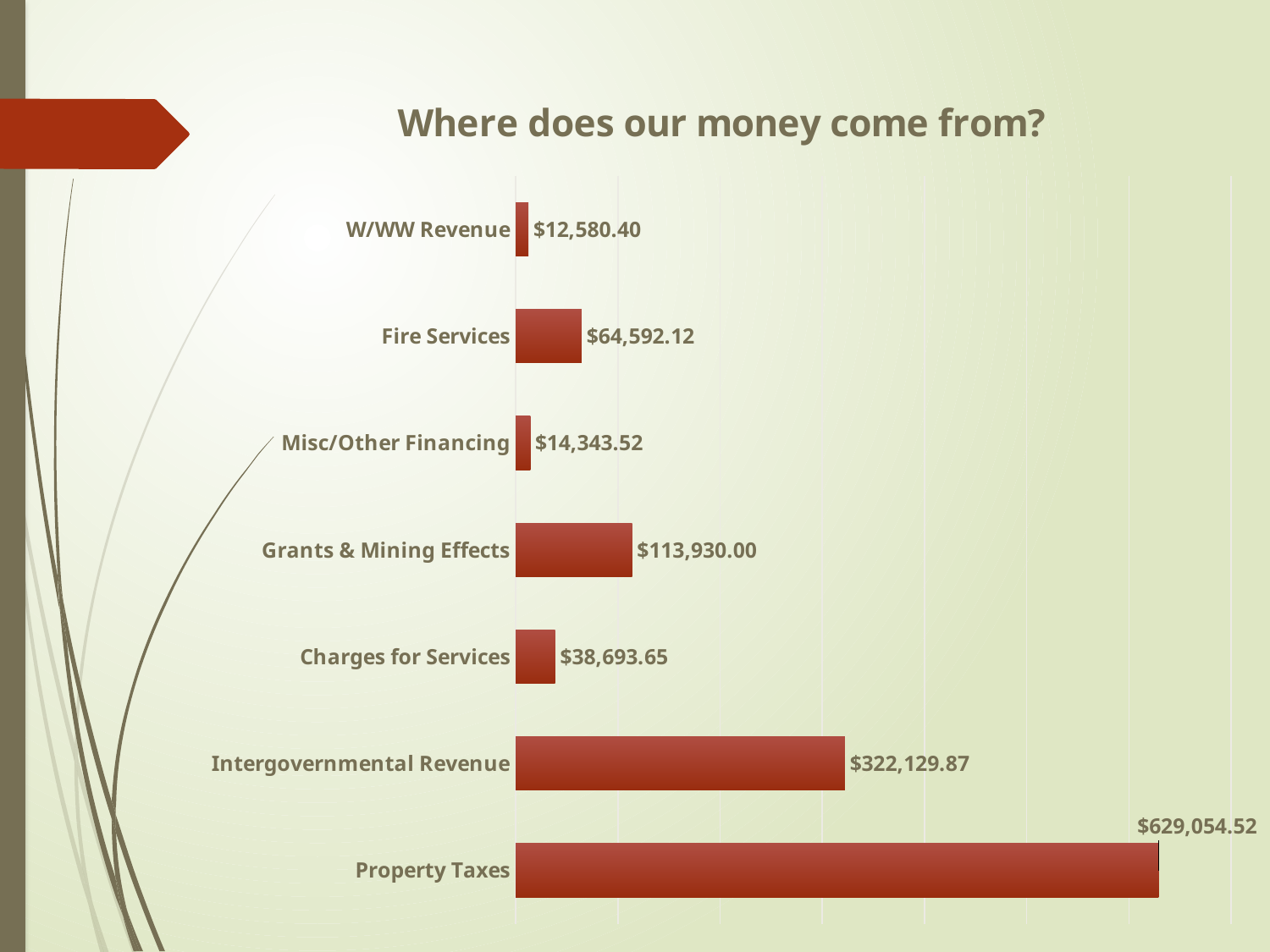
What is the value for Charges for Services? $38,693.65 Which category has the lowest value? W/WW Revenue What type of chart is shown on the slide? Bar chart What is the title of the chart? Where does our money come from? How many categories are shown in the chart? 7 What is the value for Property Taxes? $629,054.52 What is the difference between Property Taxes and Intergovernmental Revenue? $306,924.65 What is the value for Intergovernmental Revenue? $322,129.87 What is the value for Grants & Mining Effects? $113,930.00 Which is larger, Fire Services or Charges for Services? Fire Services Which category has the highest value? Property Taxes What is the difference between Misc/Other Financing and W/WW Revenue? $1,763.12